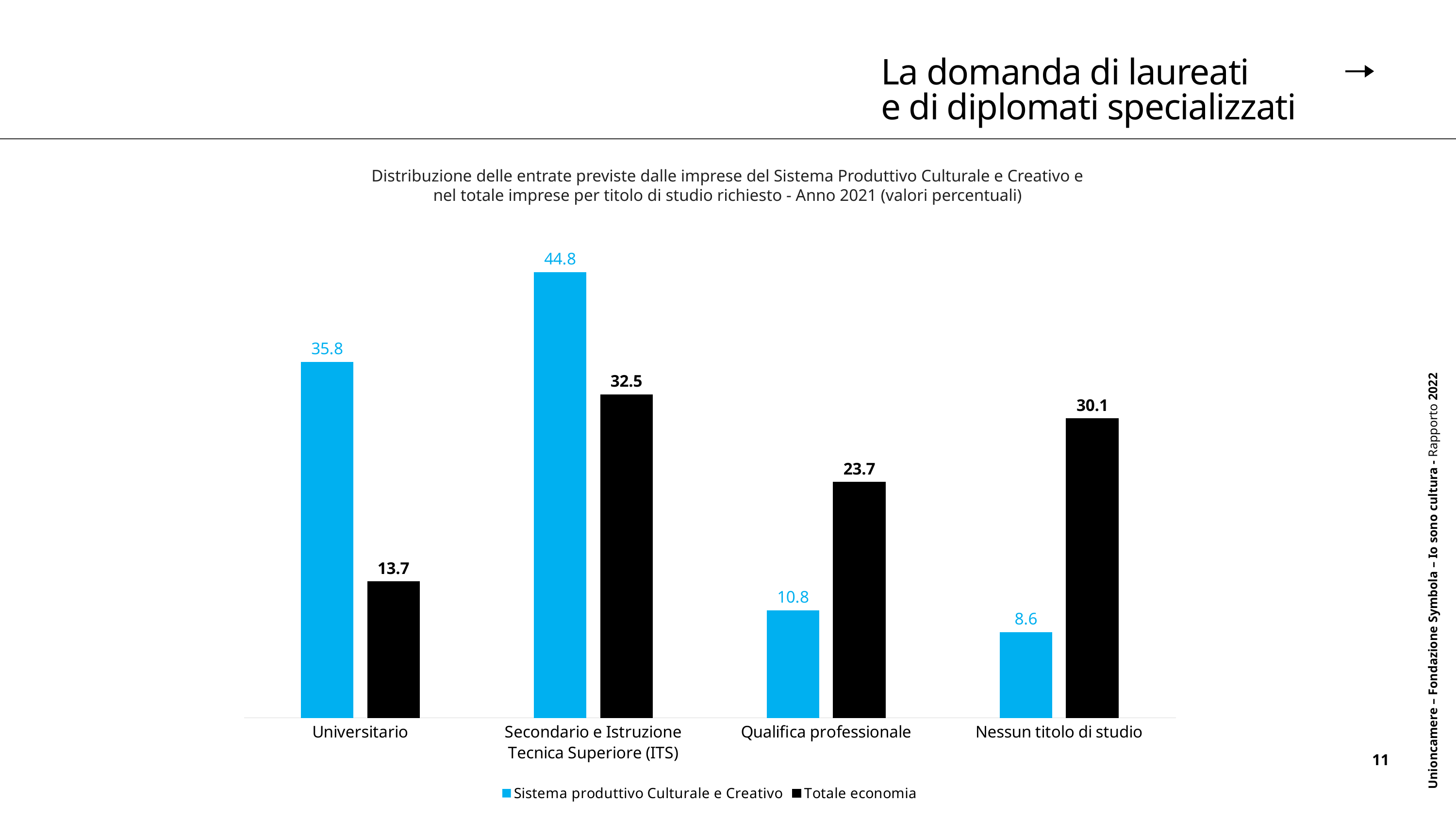
What kind of chart is shown on the slide? Bar chart Which colour represents the Totale economia series? Black For Nessun titolo di studio, which series has the larger value: Sistema produttivo Culturale e Creativo or Totale economia? Totale economia How many categories are shown on the x axis? 4 How many series does the legend list? 2 What is the difference between the Totale economia values for Secondario e Istruzione Tecnica Superiore (ITS) and Qualifica professionale? 8.8 What is the difference between the Sistema produttivo Culturale e Creativo and Totale economia values for Universitario? 22.1 What is the value for Qualifica professionale in the Sistema produttivo Culturale e Creativo series? 10.8 Which category has the lowest value in the Totale economia series? Universitario Which category has the highest value in the Sistema produttivo Culturale e Creativo series? Secondario e Istruzione Tecnica Superiore (ITS) What is the value for Nessun titolo di studio in the Totale economia series? 30.1 What is the value for Universitario in the Sistema produttivo Culturale e Creativo series? 35.8